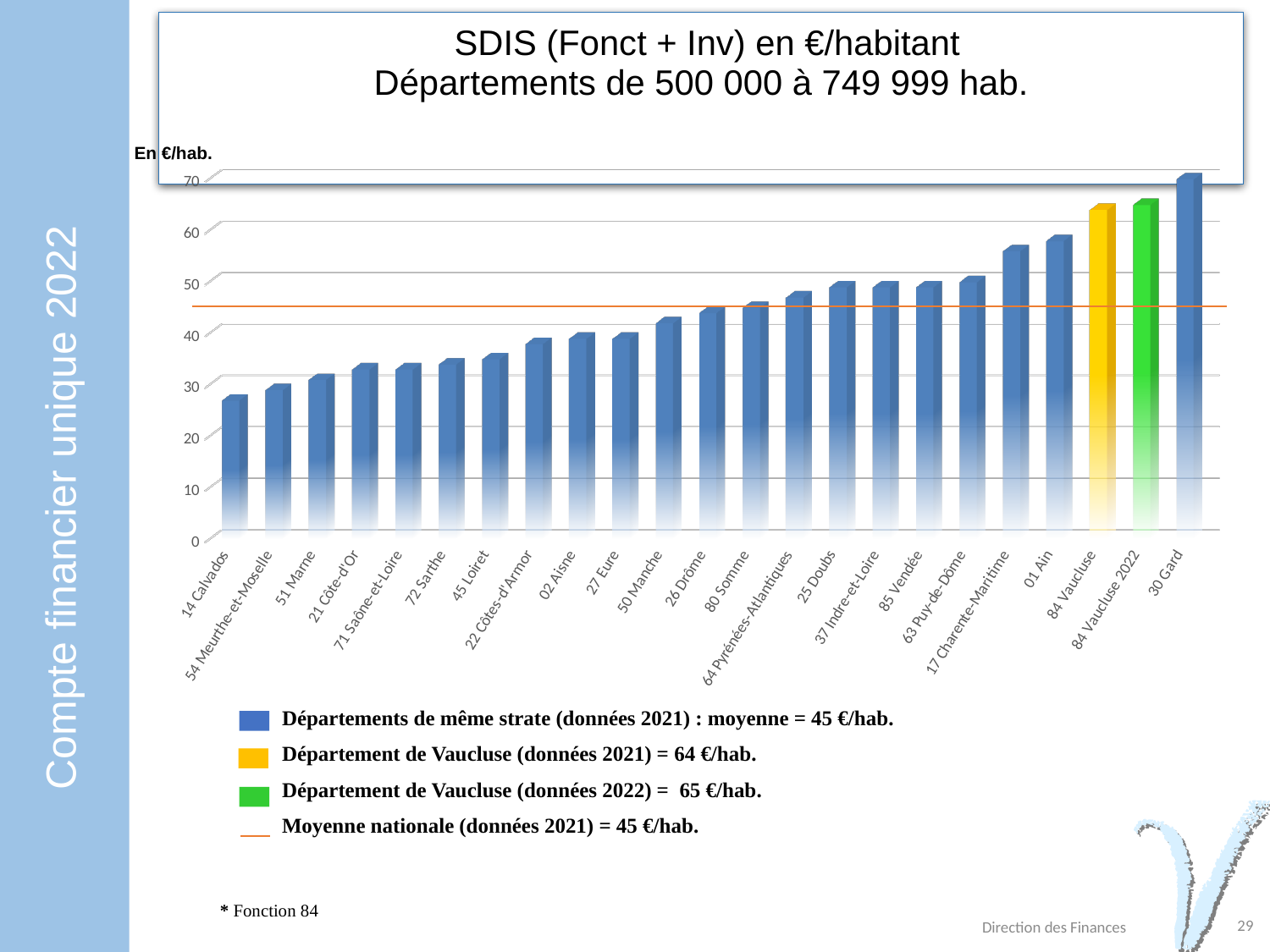
Is the value for 14 Calvados greater or less than 30? less What is the value for Département de Vaucluse (données 2021)? 64 €/hab. Which department has the highest value on the chart? 30 Gard What is the difference between the Vaucluse 2022 value and the Vaucluse 2021 value? 1 €/hab. What value does the horizontal line for the Moyenne nationale (données 2021) represent? 45 €/hab. What kind of chart is shown on the slide? Bar chart How many departments (bars) are plotted on the chart? 23 Is the value for 01 Ain greater or less than 50? greater What is the value for Département de Vaucluse (données 2022)? 65 €/hab. Which department has the lowest value on the chart? 14 Calvados Do the bar values rise or fall from left to right along the x axis? Rise What colour is the bar for 84 Vaucluse 2022? Green